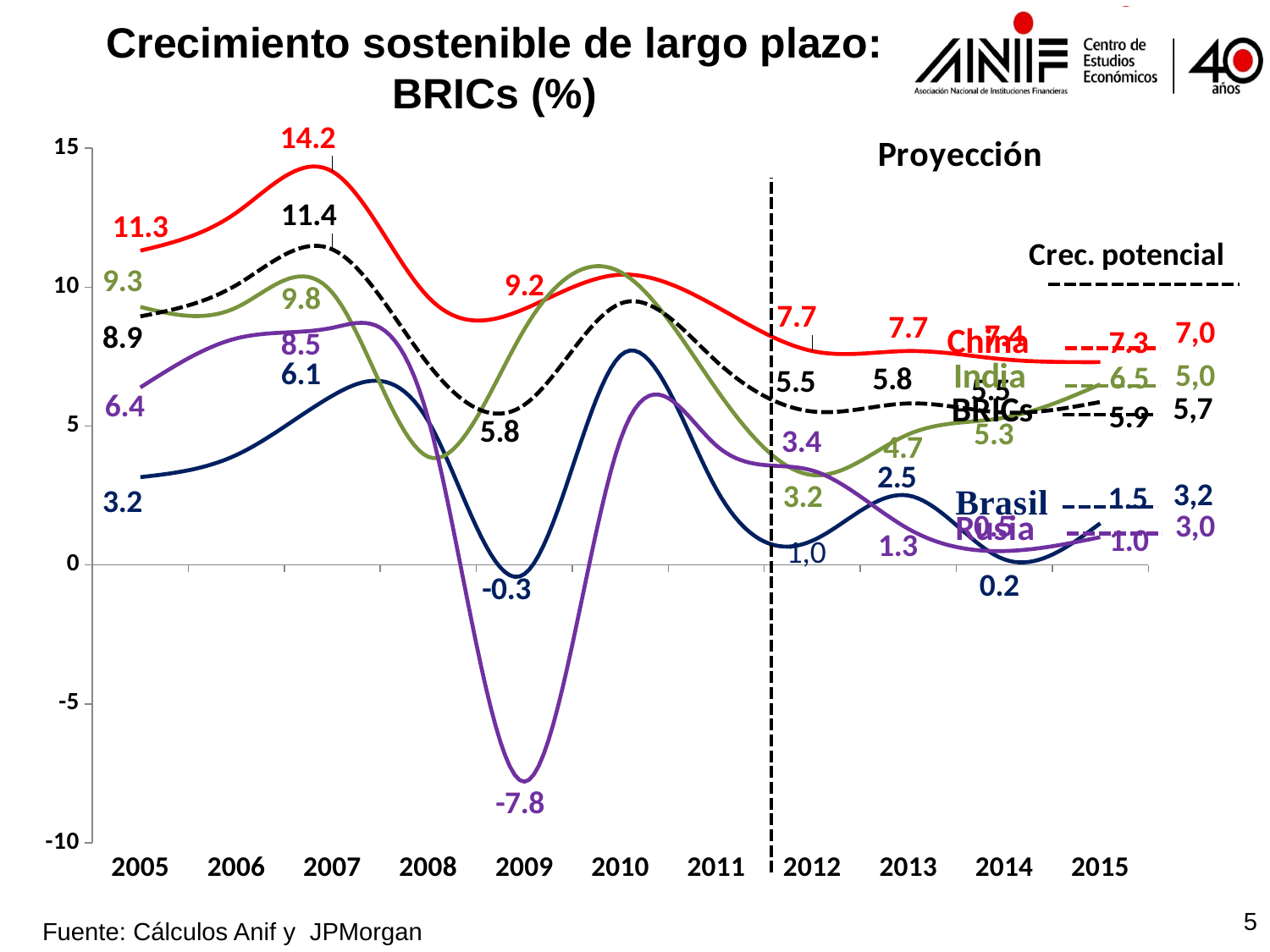
What is the value for India in 2015? 6.5 What is the title of the chart? Crecimiento sostenible de largo plazo: BRICs (%) In which year does the Rusia line reach its lowest value? 2009 What is the value for Rusia in 2009? -7.8 What is the value for Brasil in 2005? 3.2 Does the China line rise or fall from 2012 to 2015? Fall What is the difference between China's value in 2007 and its value in 2005? 2.9 How many years are shown on the x axis? 11 What is the value for China in 2007? 14.2 What type of chart is shown on the slide? Line chart In which year does the China line reach its highest value? 2007 Which is larger in 2005, the value for China or the value for India? China